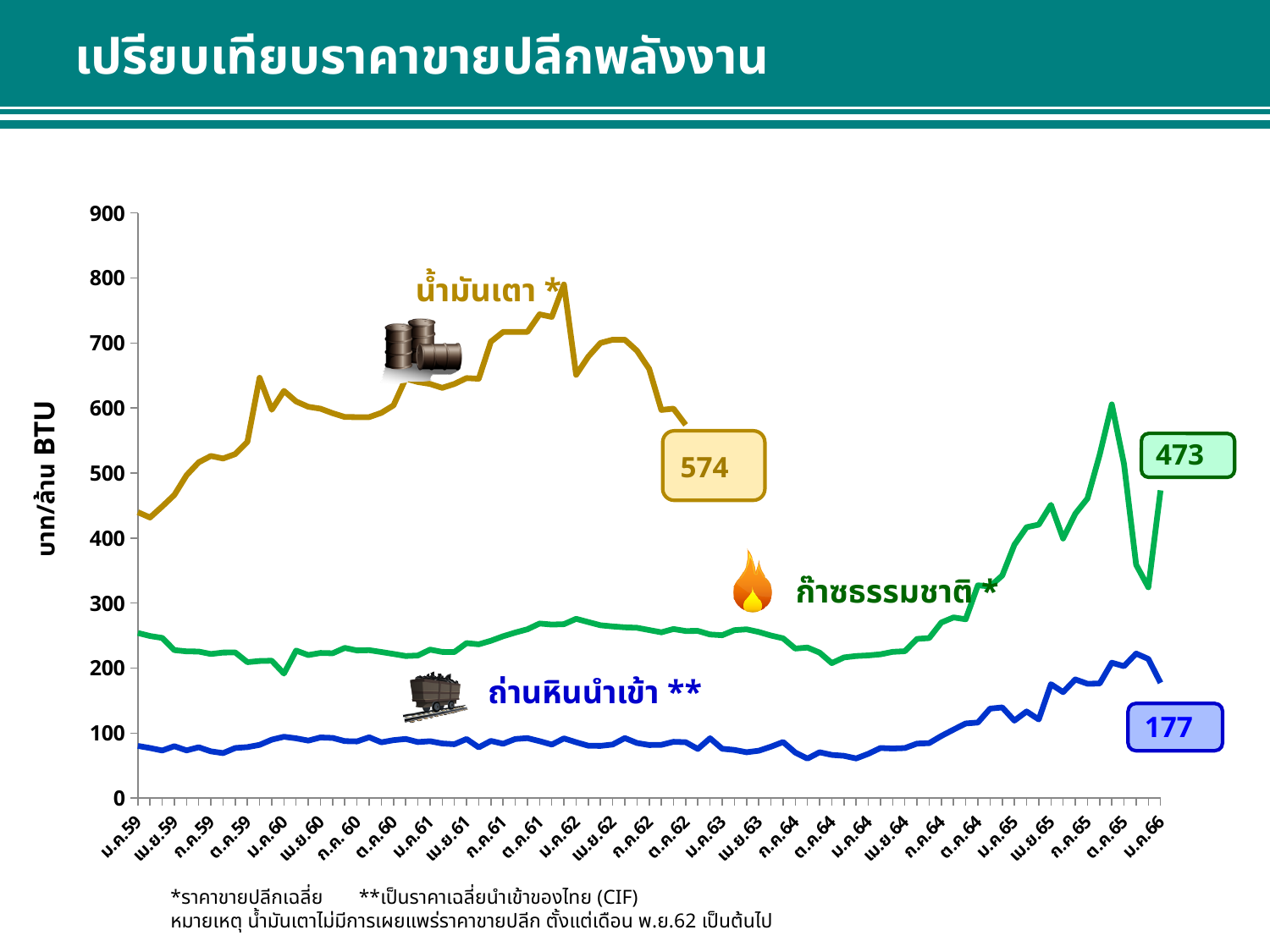
What kind of chart is shown on the slide? line chart What is the labelled value for ก๊าซธรรมชาติ at the end of the series (ม.ค.66)? 473 How many energy price series are plotted on the chart? 3 Which series has the lowest values throughout the chart? ถ่านหินนำเข้า Which series reaches the highest value on the chart? น้ำมันเตา What unit is shown on the y-axis of the chart? บาท/ล้าน BTU Is the value for ถ่านหินนำเข้า at ม.ค.59 greater or less than 100? less What is the labelled final value for น้ำมันเตา? 574 What is the labelled value for ถ่านหินนำเข้า at the end of the series? 177 Is the value for น้ำมันเตา at ม.ค.59 greater or less than 400? greater At the end of the series, which is higher: ก๊าซธรรมชาติ or ถ่านหินนำเข้า? ก๊าซธรรมชาติ What is the difference between the labelled final values of ก๊าซธรรมชาติ (473) and ถ่านหินนำเข้า (177)? 296